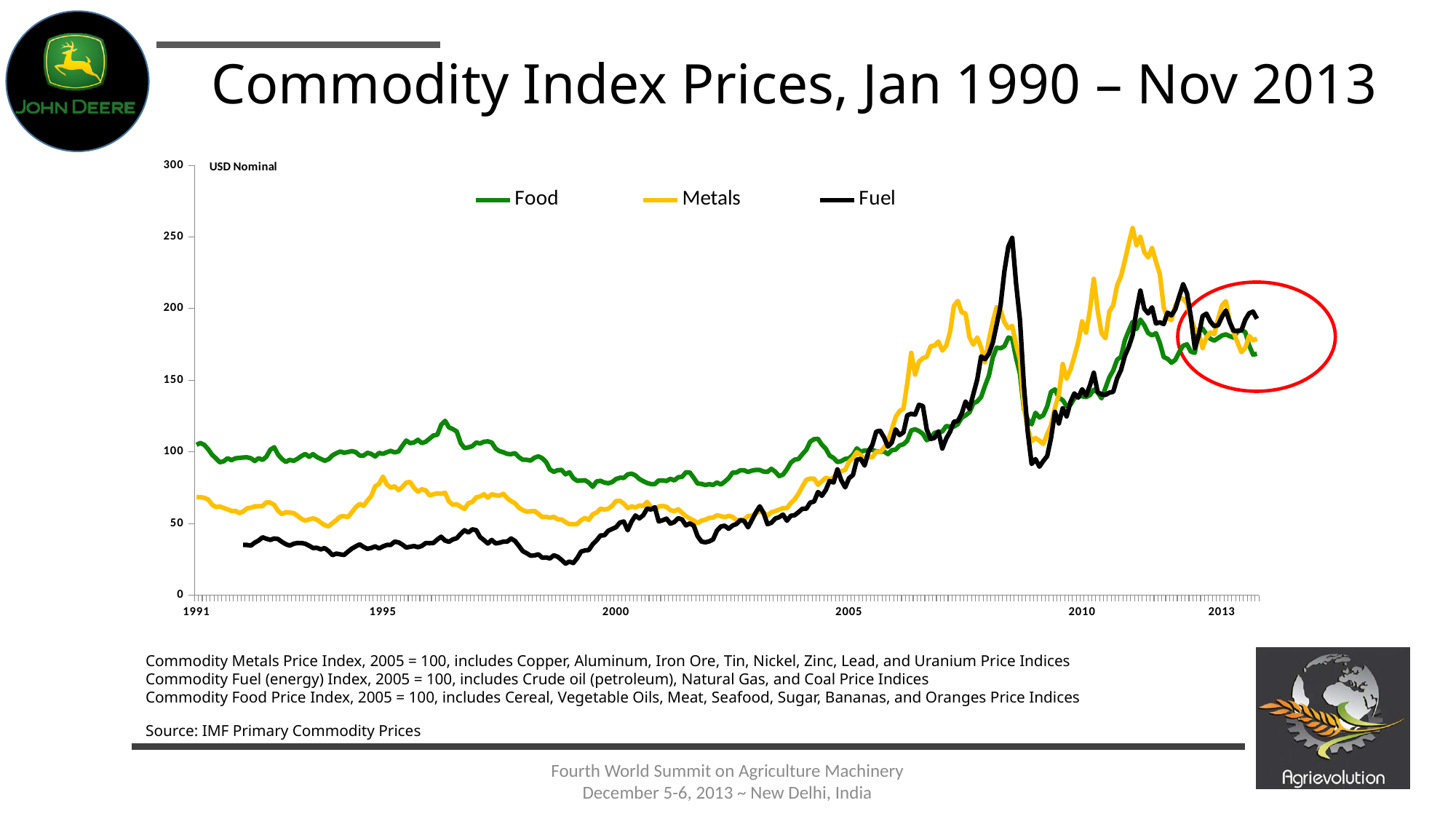
In 1995, which is larger, the value for Food or the value for Fuel? Food Does the Fuel series rise or fall overall from 1991 to 2013? rise Which series has the lowest value at the start of the chart in 1991? Metals What colour is the Fuel line? black Is the value for Fuel in 1995 greater or less than 50? less What kind of chart is shown on the slide? line chart Which series has the highest value in 1991? Food Is the value for Metals in 2000 greater or less than 100? less Which series are listed in the legend? Food, Metals, Fuel Is the value for Food in 1991 greater or less than 50? greater How many series does the legend list? 3